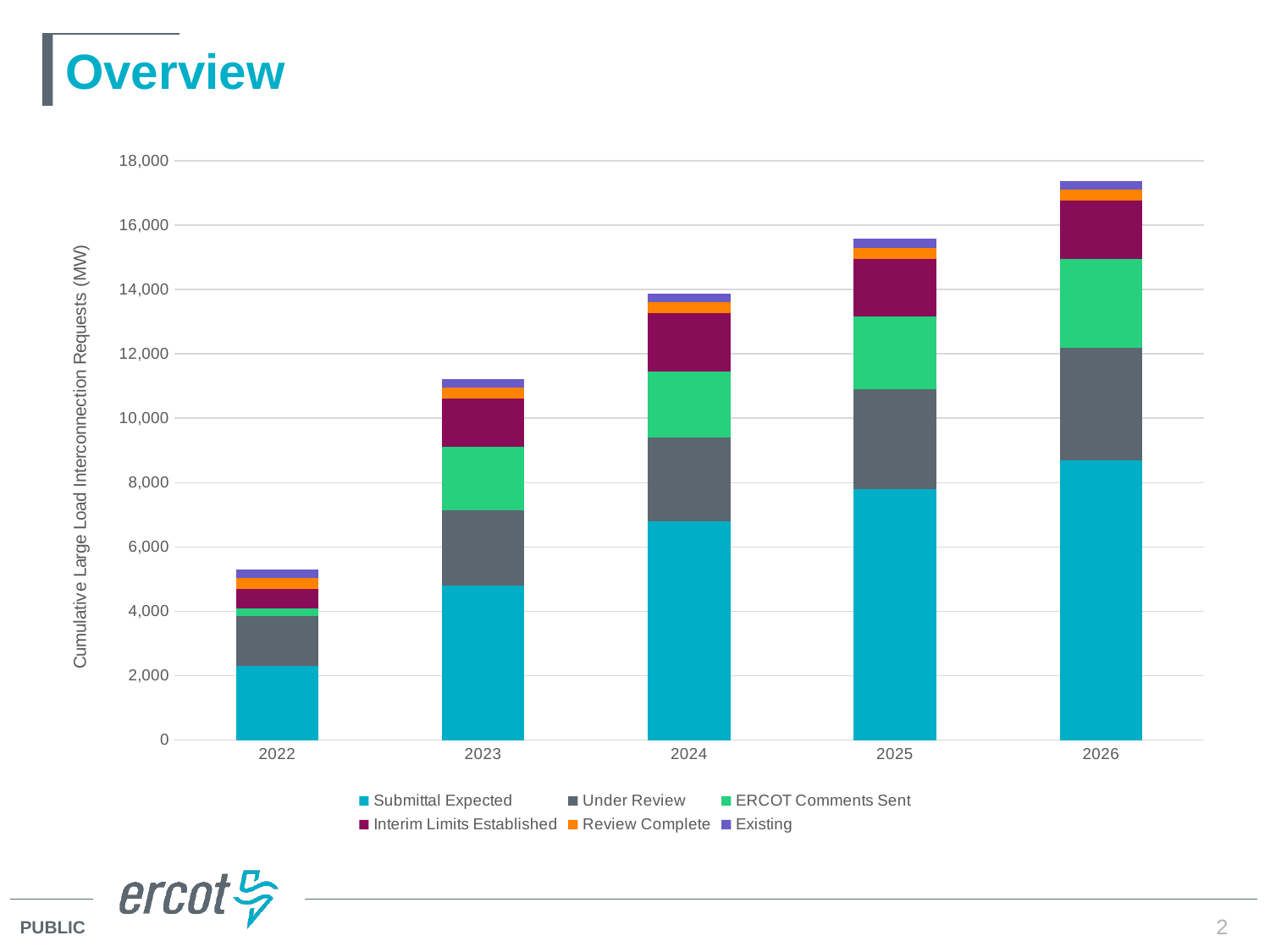
What type of chart is shown on the slide? Stacked bar chart Is the total stacked bar for 2026 greater or less than 16,000? greater Which year has the shortest stacked bar? 2022 What is the label on the chart's vertical axis? Cumulative Large Load Interconnection Requests (MW) Is the total stacked bar for 2022 greater or less than 6,000? less How many series does the chart's legend list? 6 Is the total stacked bar for 2025 greater or less than 14,000? greater Do the total bar heights rise or fall from 2022 to 2026? Rise How many years are shown on the x axis of the chart? 5 Which year has the larger total stacked bar, 2024 or 2025? 2025 Which year has the tallest stacked bar? 2026